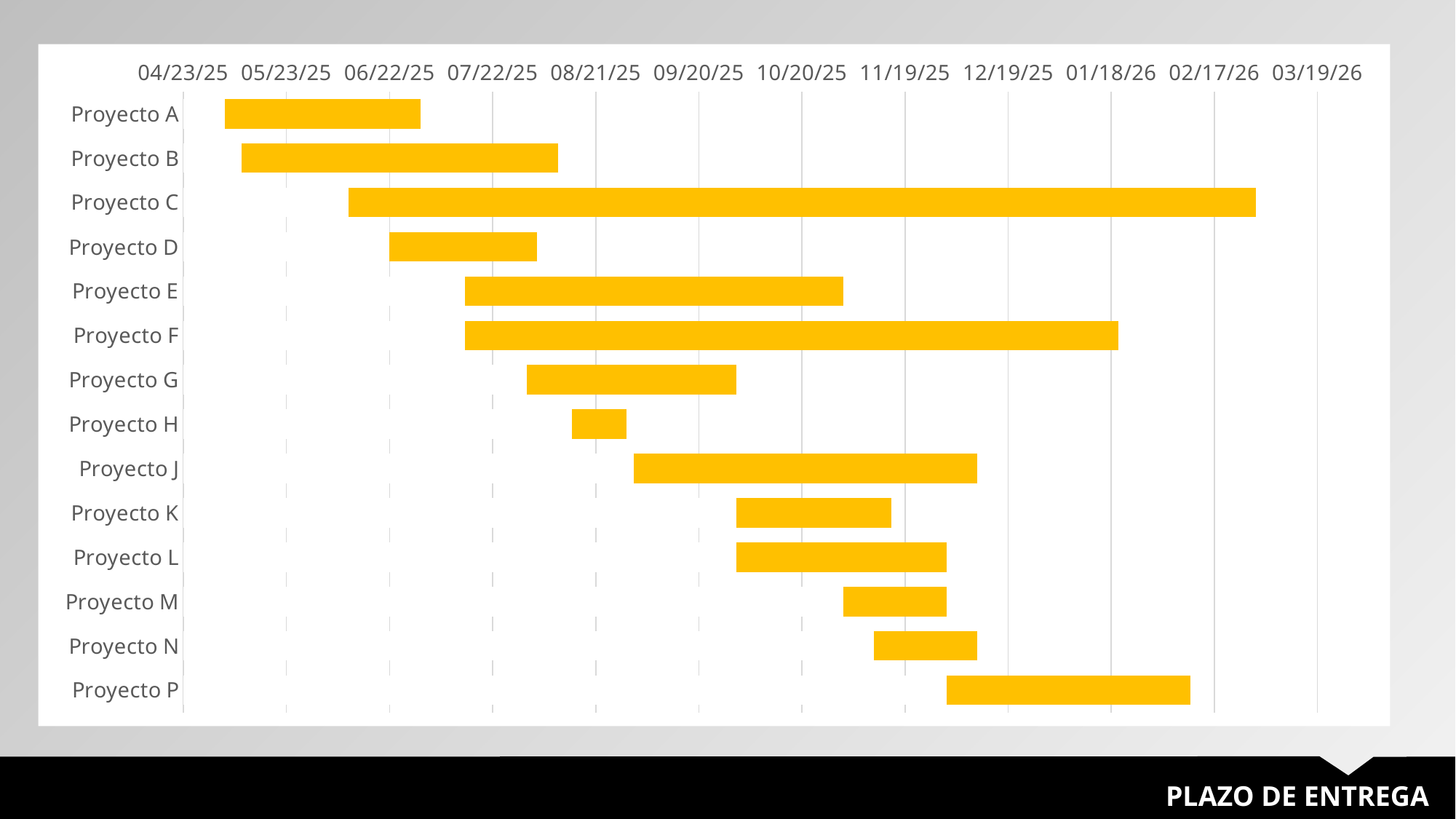
Which project is listed first at the top of the chart? Proyecto A Which bar is longer, Proyecto H or Proyecto J? Proyecto J Which project has the shortest bar in the chart? Proyecto H Does the bar for Proyecto C end before or after the 02/17/26 tick on the axis? after What is the earliest date shown on the horizontal axis? 04/23/25 Which project has the longest bar in the chart? Proyecto C Does the bar for Proyecto P start before or after the 12/19/25 tick on the axis? before Which bar is longer, Proyecto C or Proyecto D? Proyecto C What kind of chart is shown on the slide? bar chart Which project's bar ends latest on the timeline? Proyecto C What is the latest date shown on the horizontal axis? 03/19/26 How many projects are listed on the vertical axis of the chart? 14